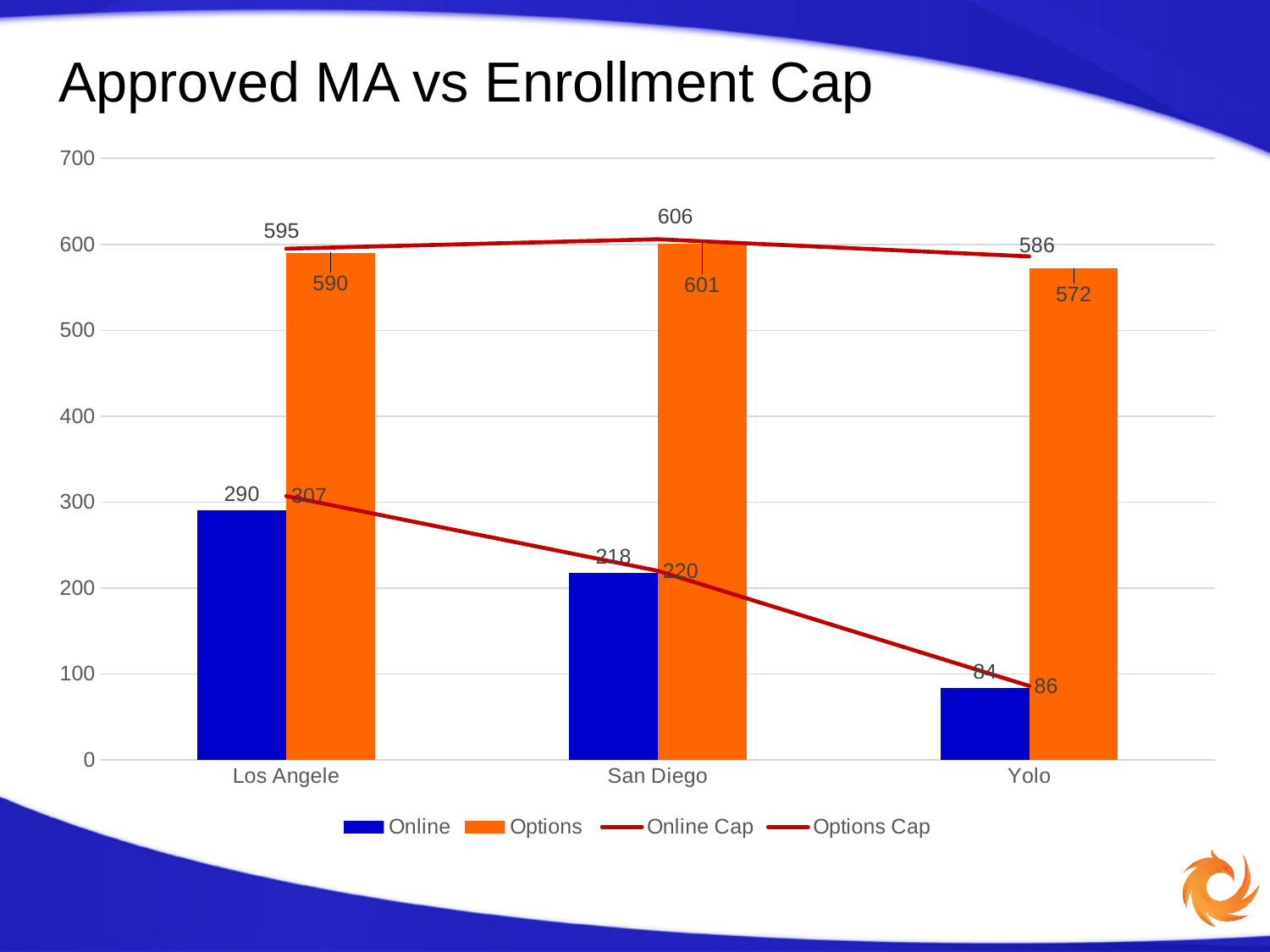
Which category has the lowest Online value? Yolo Which is larger for Yolo, the Options value or the Options Cap value? Options Cap How many series does the legend list? 4 What is the Options Cap value for San Diego? 606 How many categories are shown on the x axis? 3 What is the difference between the Online Cap and the Online value for Los Angele? 17 What is the Online Cap value for Los Angele? 307 Does the Online value rise or fall from Los Angele to Yolo? fall What is the Options value for Yolo? 572 Which category has the highest Options value? San Diego What is the Online value for San Diego? 218 What is the title of the chart? Approved MA vs Enrollment Cap